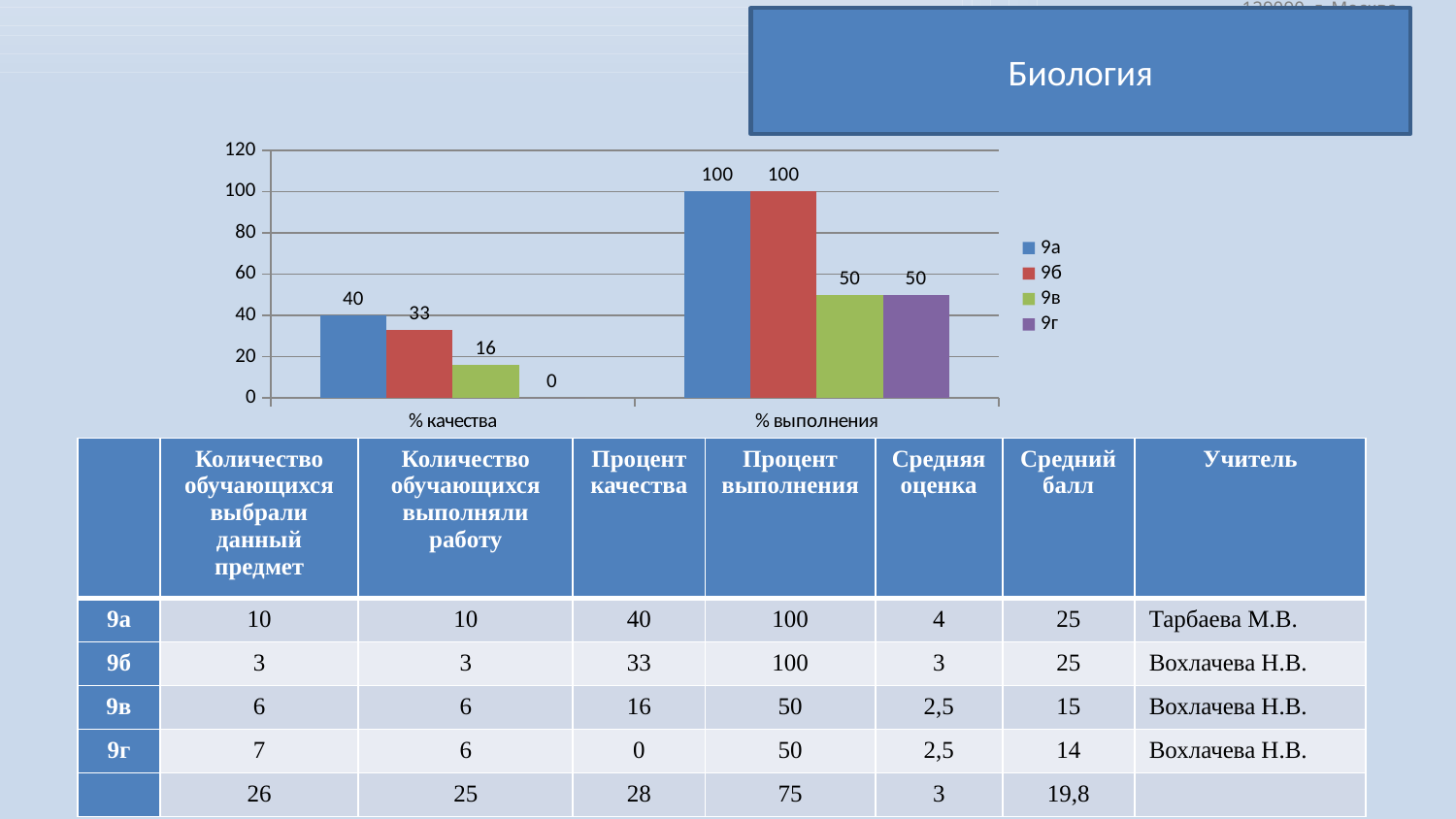
Which is larger in the % выполнения category: the value for 9б or the value for 9г? 9б What is the difference between the 9а and 9в values in the % качества category? 24 What is the value for 9г in the % качества category? 0 What is the value for 9в in the % выполнения category? 50 What type of chart is shown on the slide? bar chart What is the value for 9а in the % качества category? 40 Which series has the highest value in the % качества category? 9а What colour represents the 9б series in the chart? red Is the value for 9б in the % качества category greater or less than 20? greater How many categories are shown on the x axis of the chart? 2 How many series does the chart legend list? 4 Which series has the lowest value in the % качества category? 9г